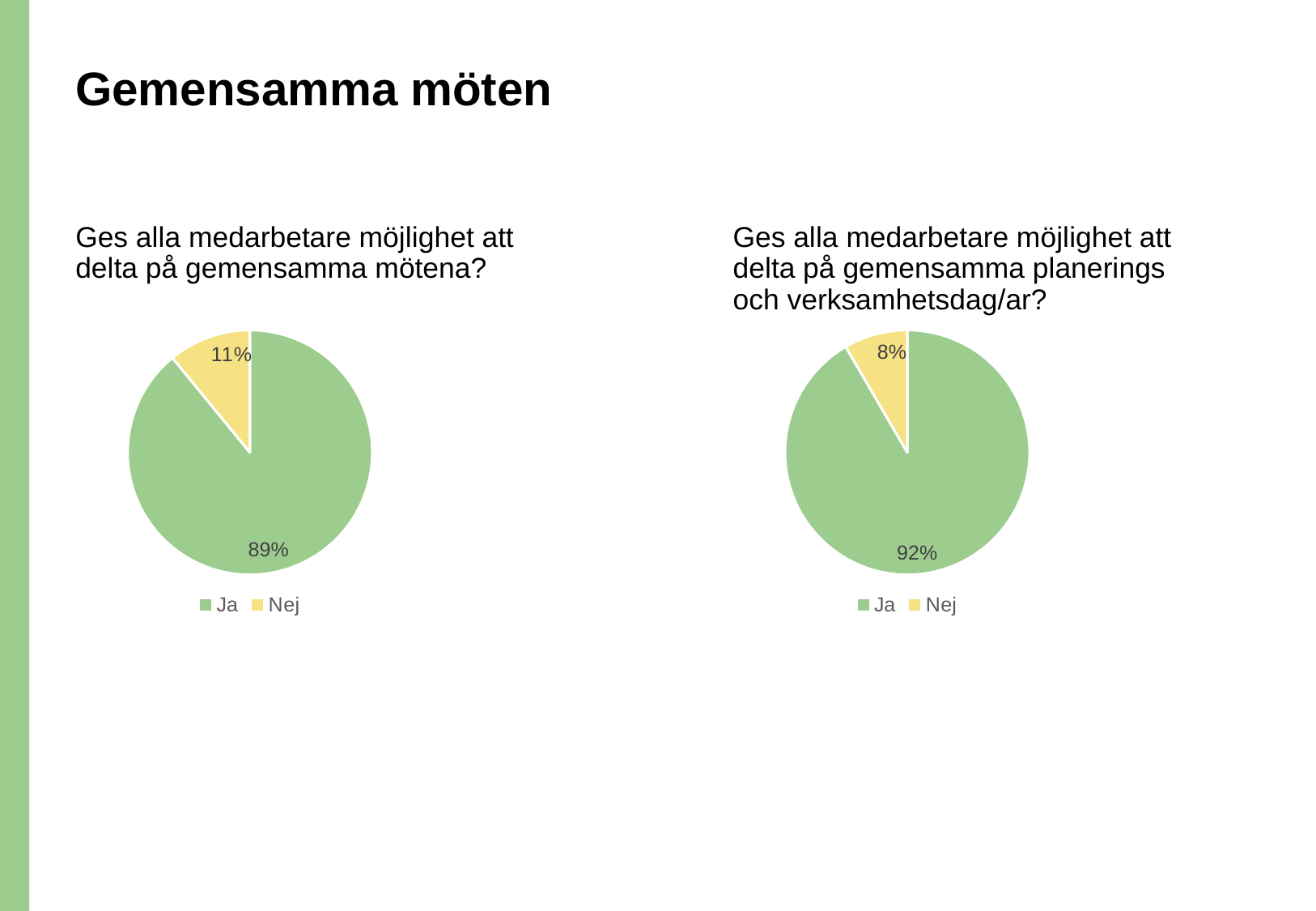
Is the Nej share larger in the left pie chart or the right pie chart? Left pie chart In the right pie chart, what is the difference between the Ja and Nej shares? 84% In the right pie chart, which slice is the smallest? Nej In the left pie chart, what is the difference between the Ja and Nej shares? 78% In the left pie chart, what colour is the Nej slice? Yellow What kind of chart is used on the left of the slide? Pie chart In the right pie chart ("Ges alla medarbetare möjlighet att delta på gemensamma planerings och verksamhetsdag/ar?"), what share is labelled for Ja? 92% In the right pie chart ("Ges alla medarbetare möjlighet att delta på gemensamma planerings och verksamhetsdag/ar?"), what share is labelled for Nej? 8% In the left pie chart, which slice is the largest? Ja In the left pie chart ("Ges alla medarbetare möjlighet att delta på gemensamma mötena?"), what share is labelled for Nej? 11% In the left pie chart ("Ges alla medarbetare möjlighet att delta på gemensamma mötena?"), what share is labelled for Ja? 89% How many entries does the legend of the right pie chart list? 2